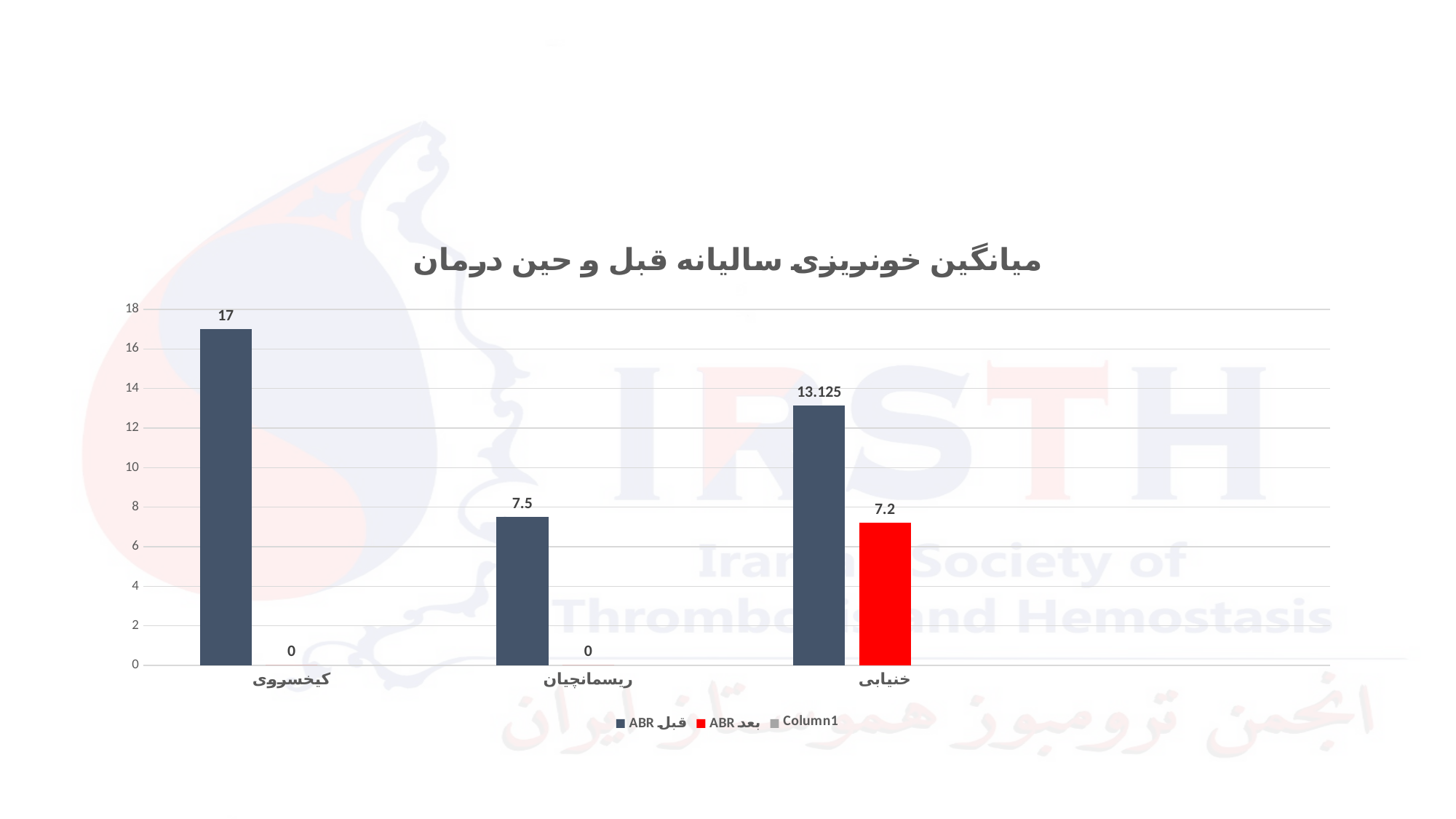
What is the difference between the ABR قبل values for کیخسروی and ریسمانچیان? 9.5 Which is larger: the ABR قبل value for ریسمانچیان or the ABR بعد value for خنیابی? ABR قبل for ریسمانچیان Which category has the highest ABR قبل value? کیخسروی What is the ABR قبل value for خنیابی? 13.125 What is the ABR قبل value for کیخسروی? 17 What is the ABR بعد value for خنیابی? 7.2 What kind of chart is shown on the slide? Bar chart How many series does the legend list? 3 What is the ABR بعد value for ریسمانچیان? 0 How many categories are shown on the x axis? 3 What is the difference between the ABR قبل and ABR بعد values for خنیابی? 5.925 Which category has the lowest ABR قبل value? ریسمانچیان